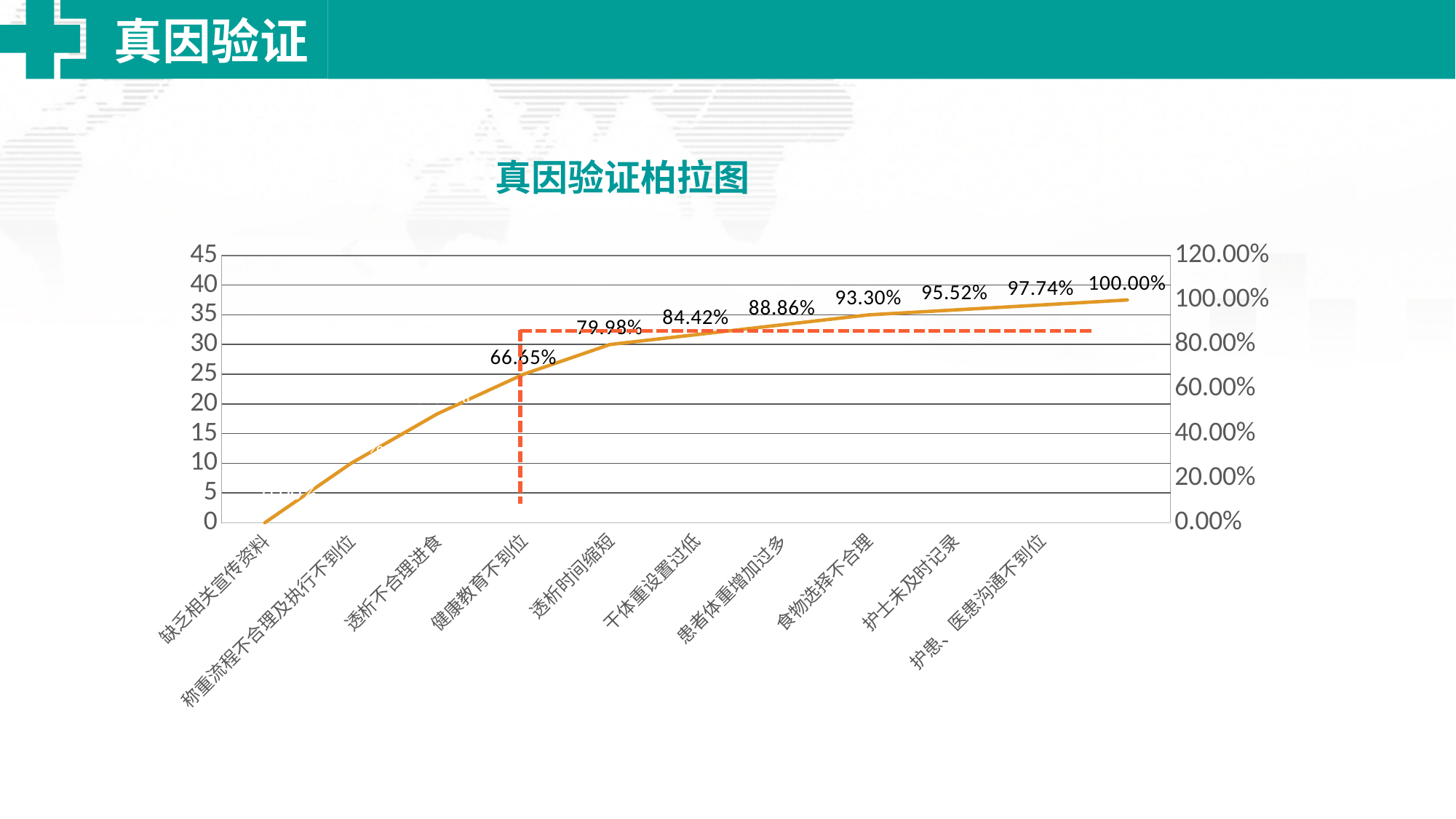
How many categories are labelled on the x axis of the chart? 10 What is the maximum value shown on the right-hand percentage axis? 120.00% What is the cumulative percentage label at 食物选择不合理? 93.30% Which is larger, the cumulative percentage at 患者体重增加过多 or at 护士未及时记录? 护士未及时记录 Does the cumulative percentage line rise or fall from left to right? rise What is the cumulative percentage label at 透析时间缩短? 79.98% Is the cumulative percentage at 干体重设置过低 greater or less than 80.00%? greater What kind of chart is shown on the slide? line chart What is the difference between the cumulative percentage labels 79.98% and 66.65%? 13.33% What is the title of the chart on the slide? 真因验证柏拉图 What is the cumulative percentage label at 健康教育不到位? 66.65% What is the highest cumulative percentage label shown on the line? 100.00%